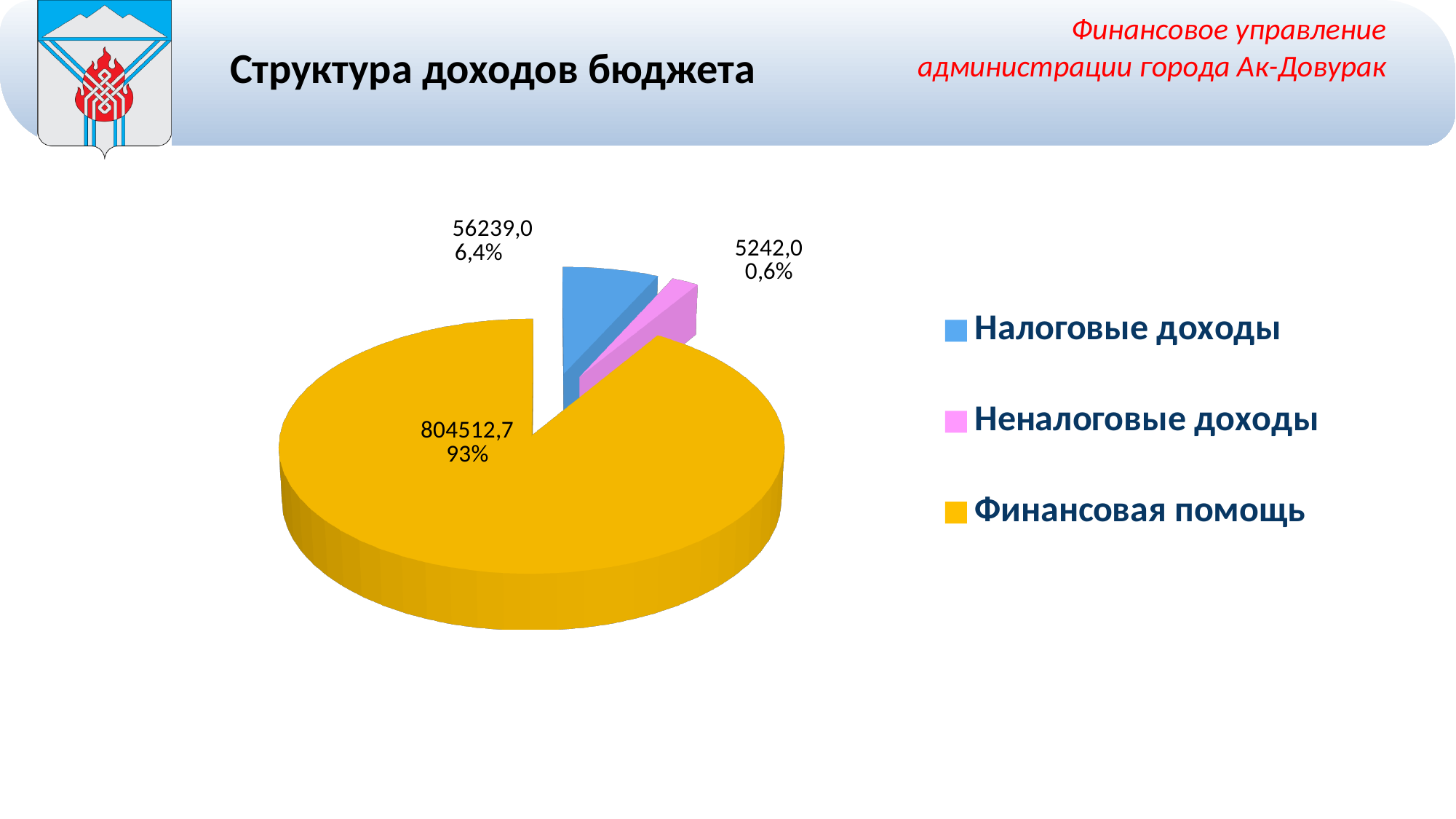
What is the value shown for Финансовая помощь? 804512,7 What type of chart is shown on the slide? Pie chart What share of the pie does Неналоговые доходы represent? 0,6% What is the value shown for Налоговые доходы? 56239,0 What colour is the slice for Неналоговые доходы? Pink What share of the pie does Налоговые доходы represent? 6,4% What is the value shown for Неналоговые доходы? 5242,0 How many slices does the pie chart have? 3 What is the difference between the values for Налоговые доходы and Неналоговые доходы? 50997,0 Which category has the smallest slice of the pie? Неналоговые доходы What share of the pie does Финансовая помощь represent? 93% Which category has the largest slice of the pie? Финансовая помощь